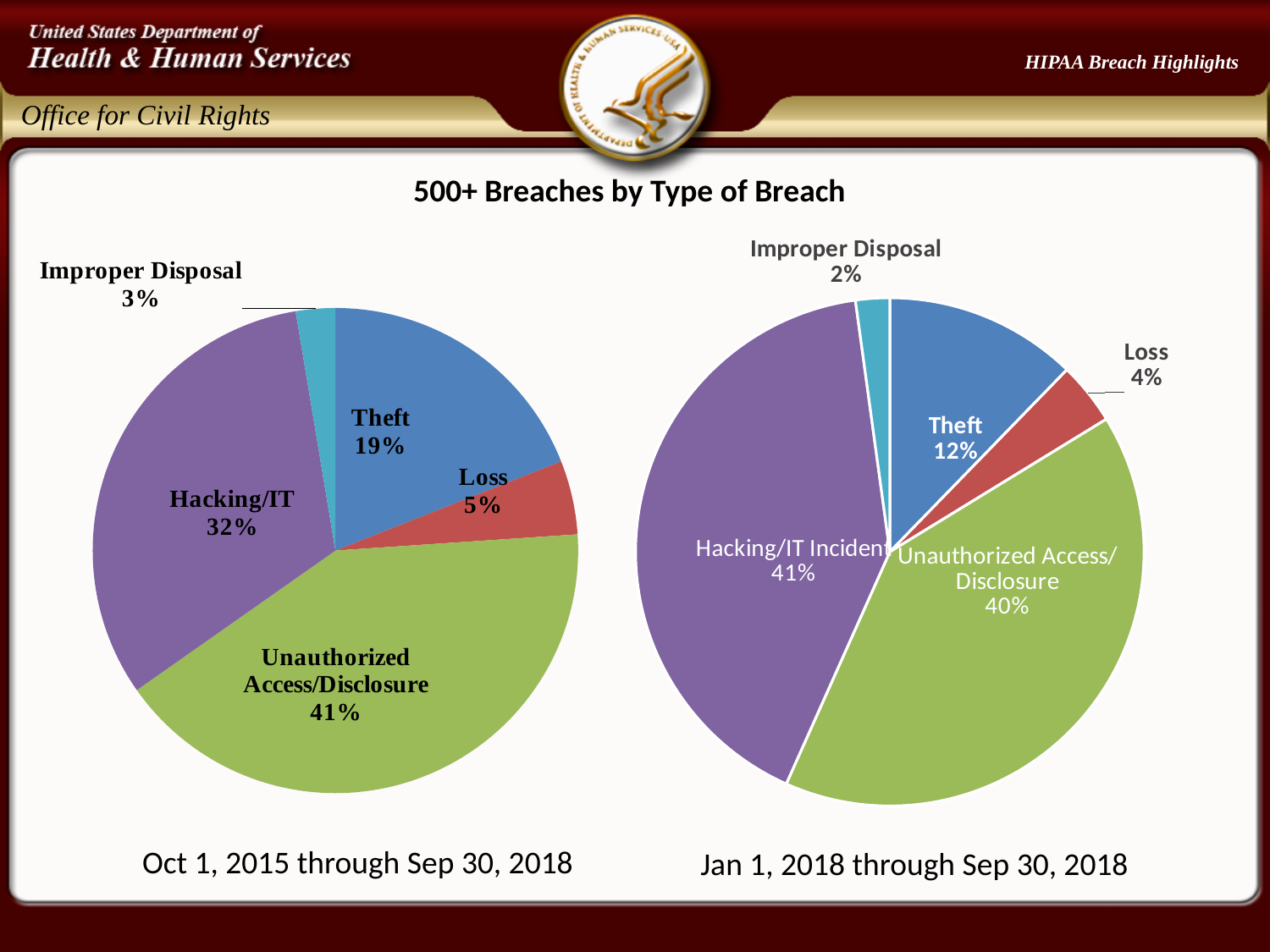
In the right pie chart (Jan 1, 2018 through Sep 30, 2018), what is the combined share of Hacking/IT Incident and Unauthorized Access/Disclosure? 81% In the right pie chart (Jan 1, 2018 through Sep 30, 2018), what share of breaches is Loss? 4% In the left pie chart (Oct 1, 2015 through Sep 30, 2018), which type of breach has the largest share? Unauthorized Access/Disclosure In the left pie chart (Oct 1, 2015 through Sep 30, 2018), what share of breaches is Hacking/IT? 32% In the left pie chart (Oct 1, 2015 through Sep 30, 2018), what is the difference in percentage points between Theft and Loss? 14 percentage points In the left pie chart (Oct 1, 2015 through Sep 30, 2018), what share of breaches is Improper Disposal? 3% What kind of chart is used on this slide? Pie chart What is the title shown above the two pie charts? 500+ Breaches by Type of Breach How many slices does the left pie chart (Oct 1, 2015 through Sep 30, 2018) have? 5 In the right pie chart (Jan 1, 2018 through Sep 30, 2018), which type of breach has the smallest share? Improper Disposal In the right pie chart (Jan 1, 2018 through Sep 30, 2018), what share of breaches is Theft? 12% In the right pie chart (Jan 1, 2018 through Sep 30, 2018), which is larger, Theft or Loss? Theft